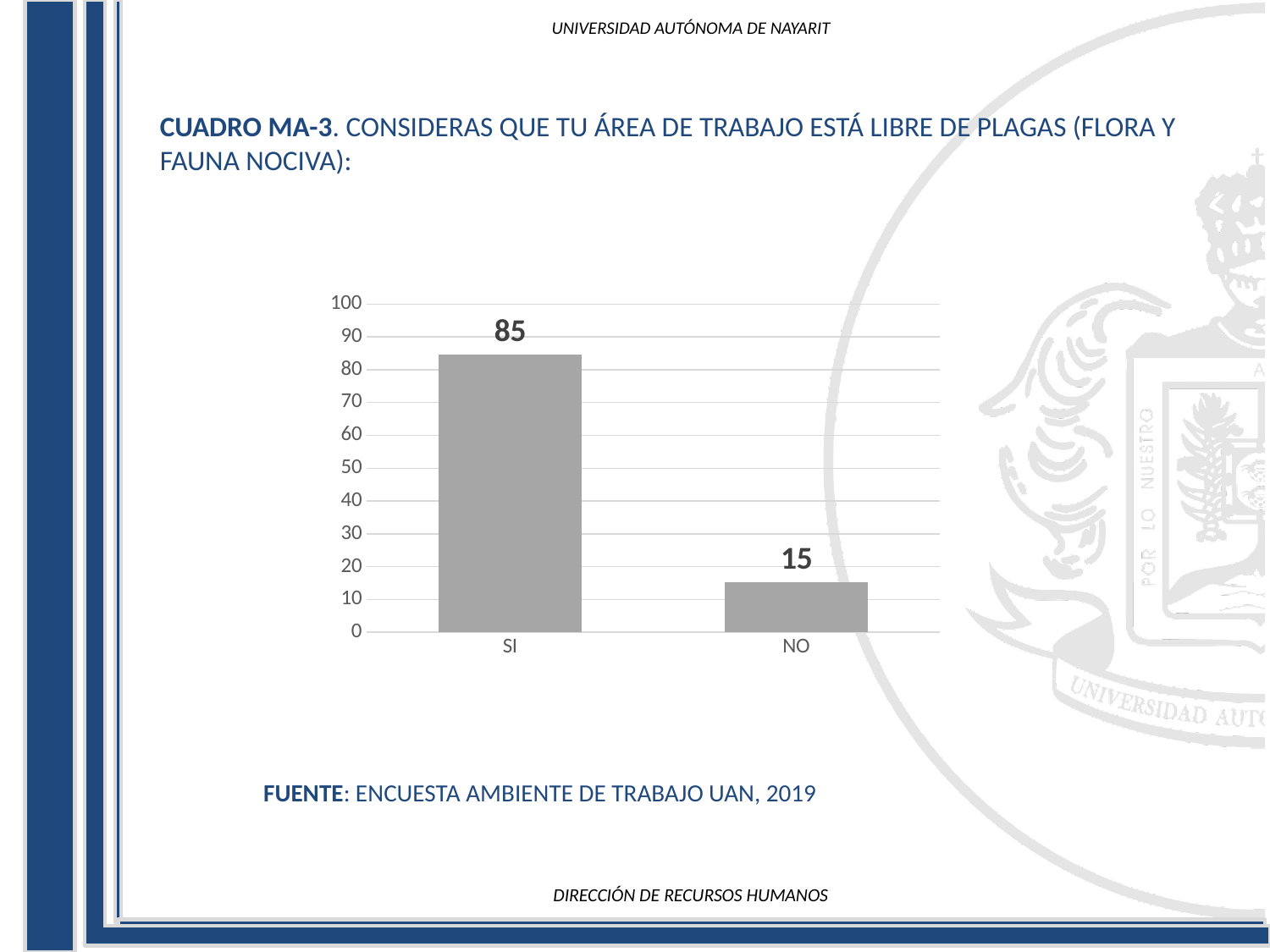
Is the value for SI greater or less than 50? greater What is the highest value shown on the y axis? 100 Which is larger, the value for SI or the value for NO? SI Is the value for NO greater or less than 20? less How many categories are shown on the x axis? 2 What source is cited below the chart? ENCUESTA AMBIENTE DE TRABAJO UAN, 2019 What kind of chart is shown on the slide? bar chart Which category has the lowest value? NO What is the value for SI? 85 Which category has the highest value? SI What is the difference between the values for SI and NO? 70 What is the value for NO? 15